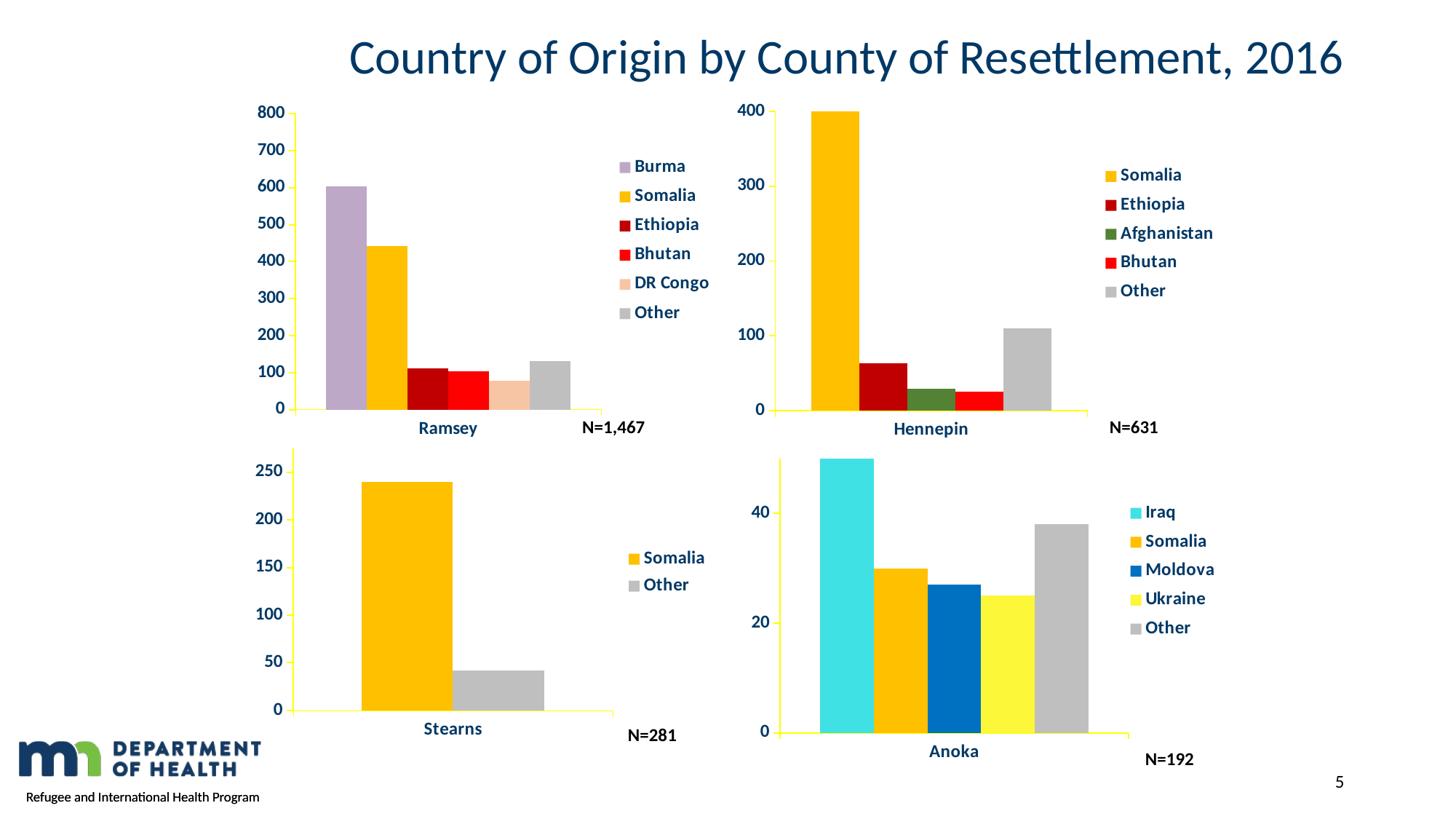
How many bars are in the Stearns chart? 2 In the Hennepin chart, which country has the lowest bar? Bhutan In the Hennepin chart, is the value for Somalia greater or less than 300? greater In the Hennepin chart, which is larger, Ethiopia or Afghanistan? Ethiopia In the Stearns chart, is the value for Somalia greater or less than 200? greater In the Ramsey chart, is the value for Burma greater or less than 500? greater How many series does the legend of the Ramsey chart list? 6 In the Ramsey chart, which country has the highest bar? Burma In the Anoka chart, which country has the highest bar? Iraq In the Anoka chart, which is larger, Moldova or Ukraine? Moldova What kind of chart is the Anoka chart? Bar chart